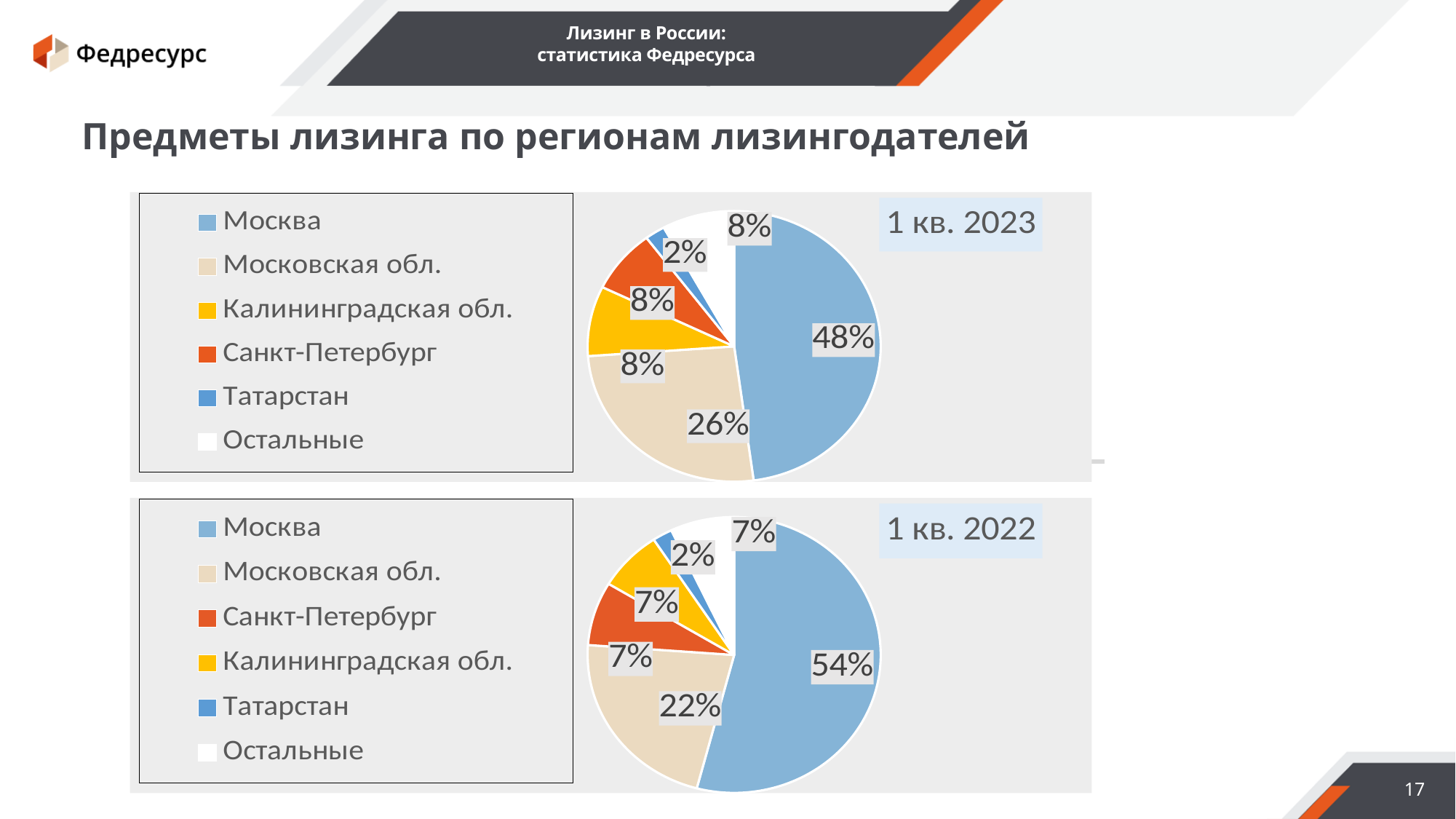
In the "1 кв. 2022" pie chart, what share does Москва have? 54% How many slices does the "1 кв. 2022" pie chart have? 6 In the "1 кв. 2023" pie chart, what share does Москва have? 48% In the "1 кв. 2022" pie chart, what share does Санкт-Петербург have? 7% In the "1 кв. 2023" pie chart, what share does Московская обл. have? 26% In the "1 кв. 2023" pie chart, which is larger: the share of Московская обл. or the share of Санкт-Петербург? Московская обл. In the "1 кв. 2022" pie chart, which region has the smallest share? Татарстан What type of chart is used for "1 кв. 2023"? Pie chart In the "1 кв. 2023" pie chart, which region has the largest share? Москва In the "1 кв. 2023" pie chart, what share does Татарстан have? 2% In the "1 кв. 2022" pie chart, what share does Московская обл. have? 22% What is the difference between the share of Москва in the "1 кв. 2022" pie chart and in the "1 кв. 2023" pie chart? 6%